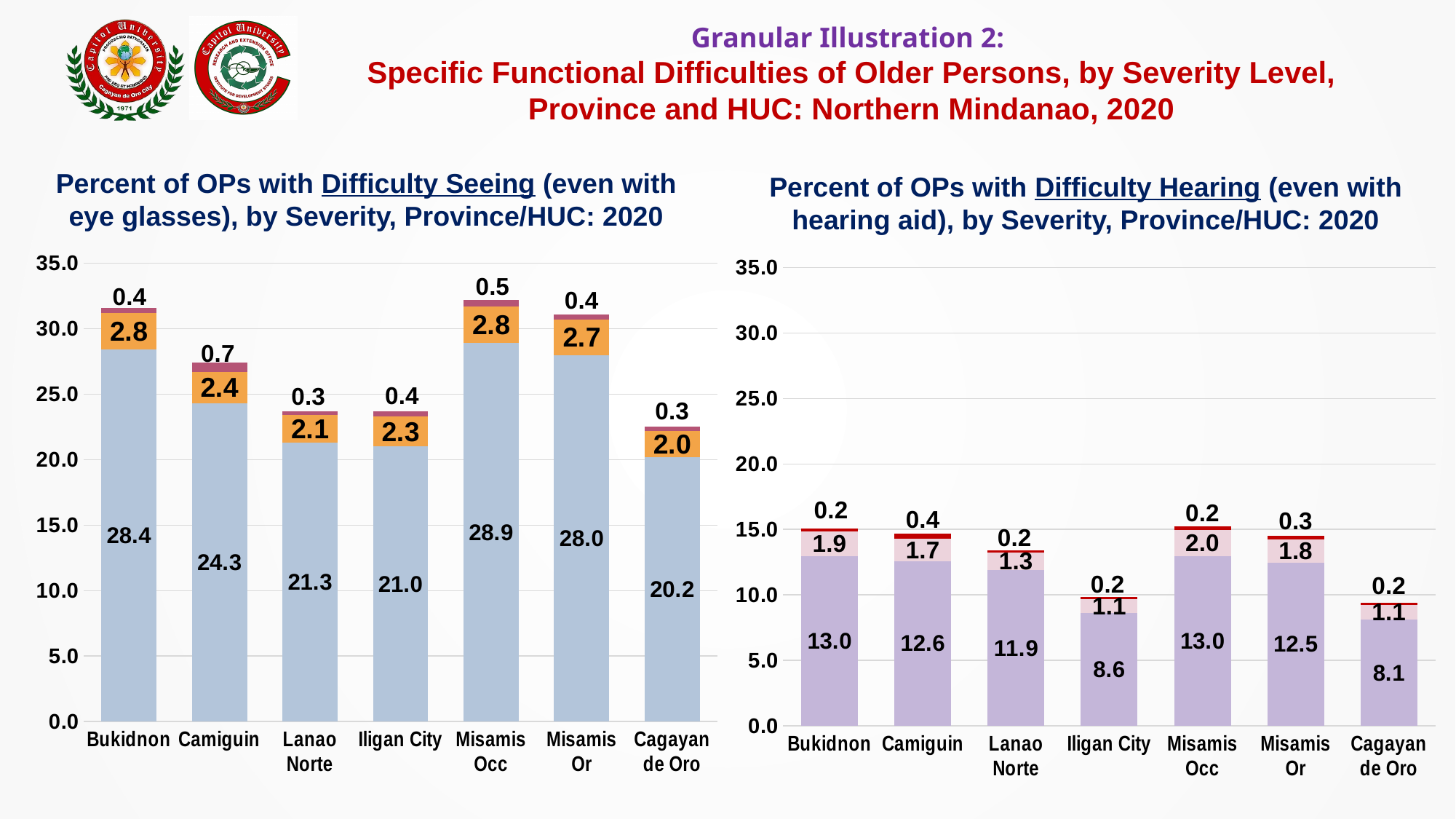
In the Difficulty Hearing chart, what is the value of the top (red) segment for Camiguin? 0.4 In the Difficulty Seeing chart, what is the value of the bottom (light blue) segment for Bukidnon? 28.4 In the Difficulty Seeing chart, which province/HUC has the lowest bottom (light blue) segment value? Cagayan de Oro How many provinces/HUCs are shown on the x axis of the Difficulty Hearing chart? 7 In the Difficulty Seeing chart, what is the difference between the bottom segment values for Bukidnon and Cagayan de Oro? 8.2 In the Difficulty Hearing chart, what is the total of the stacked bar for Iligan City? 9.9 In the Difficulty Seeing chart, what is the total of the stacked bar for Misamis Occ? 32.2 In the Difficulty Hearing chart, which province/HUC has the lowest bottom (purple) segment value? Cagayan de Oro In the Difficulty Hearing chart, is the bottom segment value for Camiguin or Misamis Or larger? Camiguin In the Difficulty Hearing chart, what is the value of the bottom (purple) segment for Iligan City? 8.6 In the Difficulty Seeing chart, what is the value of the middle (orange) segment for Camiguin? 2.4 In the Difficulty Seeing chart, which province/HUC has the highest bottom (light blue) segment value? Misamis Occ